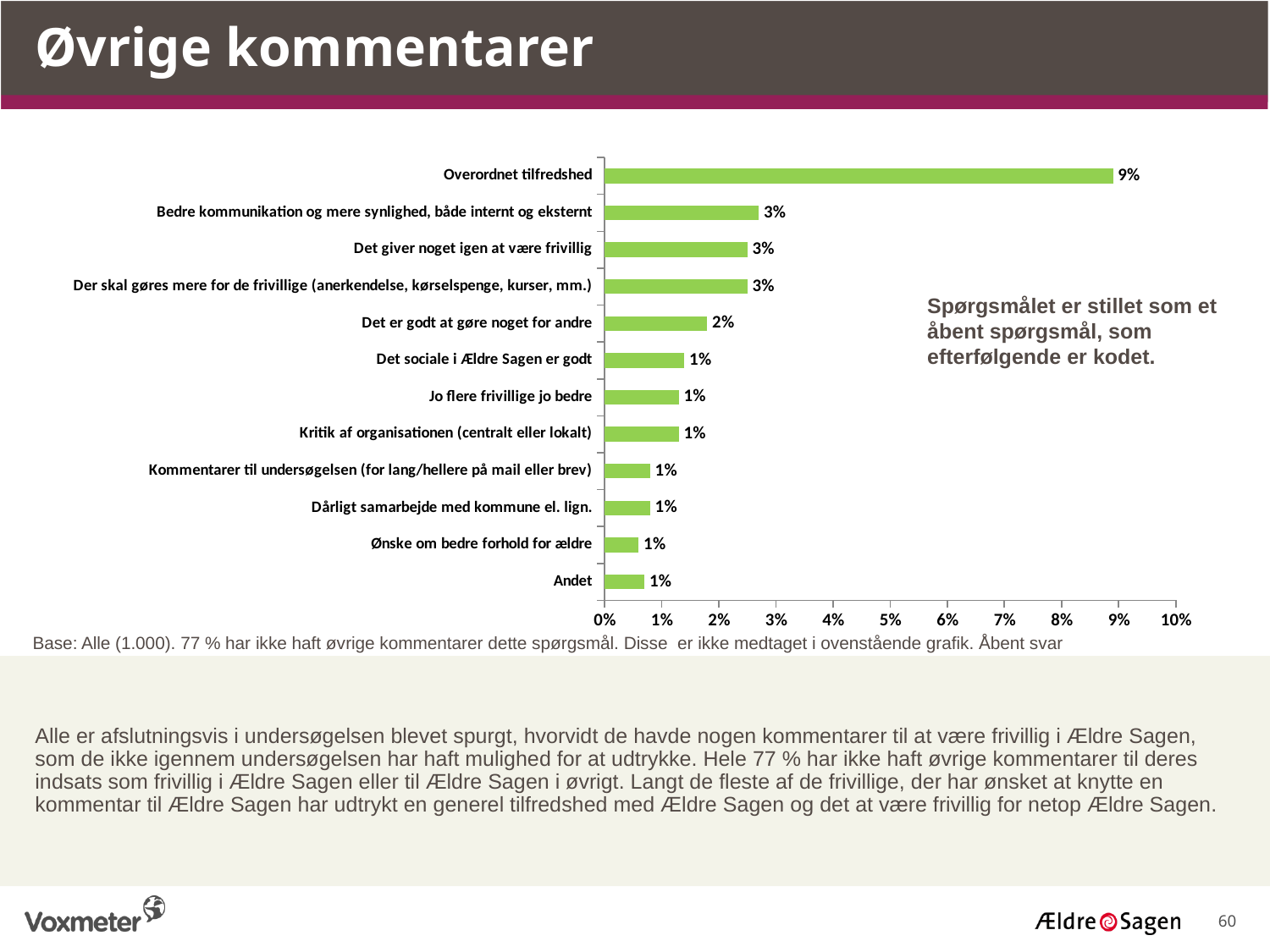
What is the value for "Bedre kommunikation og mere synlighed, både internt og eksternt"? 3% Which category has the highest value? Overordnet tilfredshed What kind of chart is shown on the slide? bar chart Which is larger, the value for "Overordnet tilfredshed" or the value for "Det er godt at gøre noget for andre"? Overordnet tilfredshed What is the value for "Det er godt at gøre noget for andre"? 2% How many categories are shown in the chart? 12 What colour are the bars in the chart? green Is the value for "Overordnet tilfredshed" greater or less than 8%? greater What is the value for "Overordnet tilfredshed"? 9% What is the difference between the values for "Det er godt at gøre noget for andre" and "Det sociale i Ældre Sagen er godt"? 1% What is the value for "Andet"? 1% What is the difference between the values for "Overordnet tilfredshed" and "Det giver noget igen at være frivillig"? 6%